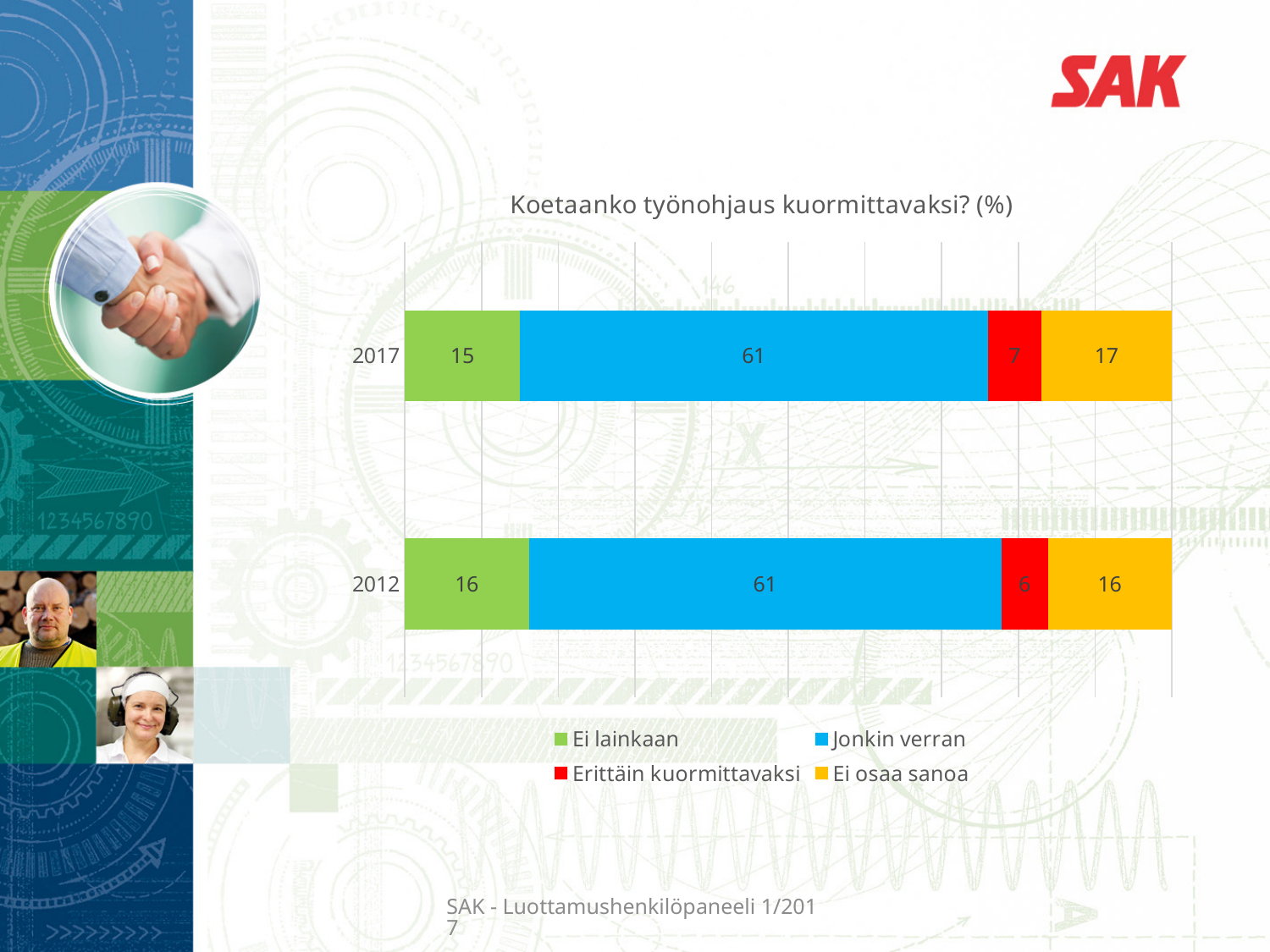
What kind of chart is shown on the slide? Stacked bar chart Is the value for "Erittäin kuormittavaksi" larger in 2017 or in 2012? 2017 How many years (categories) are shown in the chart? 2 What is the value for "Jonkin verran" in 2017? 61 How many series does the legend list? 4 What is the value for "Erittäin kuormittavaksi" in 2017? 7 What is the value for "Ei lainkaan" in 2012? 16 What is the difference between "Ei osaa sanoa" and "Ei lainkaan" in 2017? 2 Which series has the lowest value in 2012? Erittäin kuormittavaksi What is the value for "Ei osaa sanoa" in 2012? 16 Which series has the highest value in 2017? Jonkin verran What is the total of the stacked bar for 2012? 99